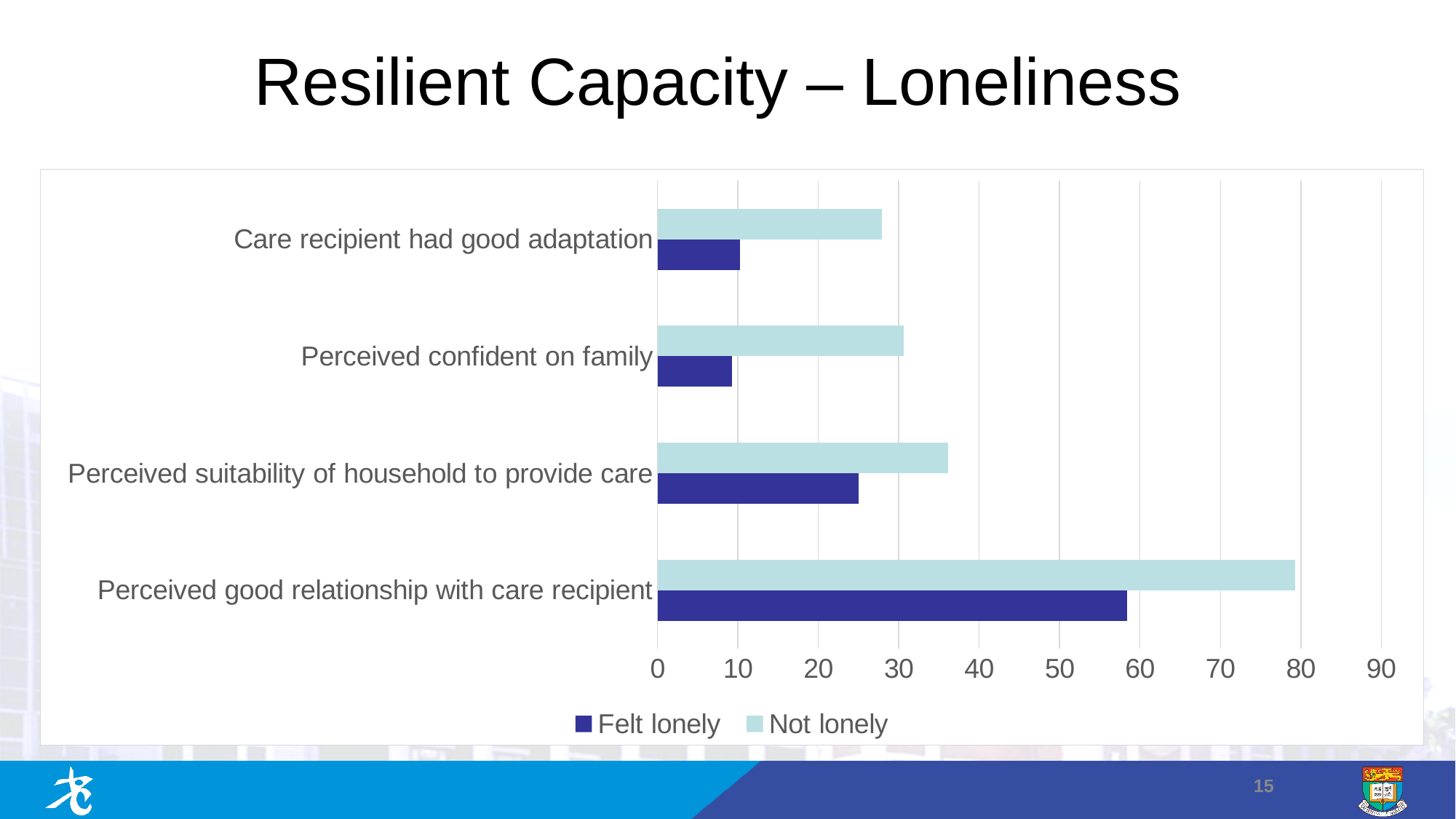
Is the Felt lonely value for Perceived suitability of household to provide care greater or less than 30? less How many categories are shown on the chart? 4 What is the title of the slide containing the chart? Resilient Capacity – Loneliness Which category has the highest value for the Felt lonely series? Perceived good relationship with care recipient Is the Felt lonely value for Perceived good relationship with care recipient greater or less than 50? greater Which category has the highest value for the Not lonely series? Perceived good relationship with care recipient For Perceived suitability of household to provide care, which series has the larger value, Felt lonely or Not lonely? Not lonely What kind of chart is shown on the slide? bar chart How many series does the legend list? 2 Is the Felt lonely value for Perceived confident on family greater or less than 20? less